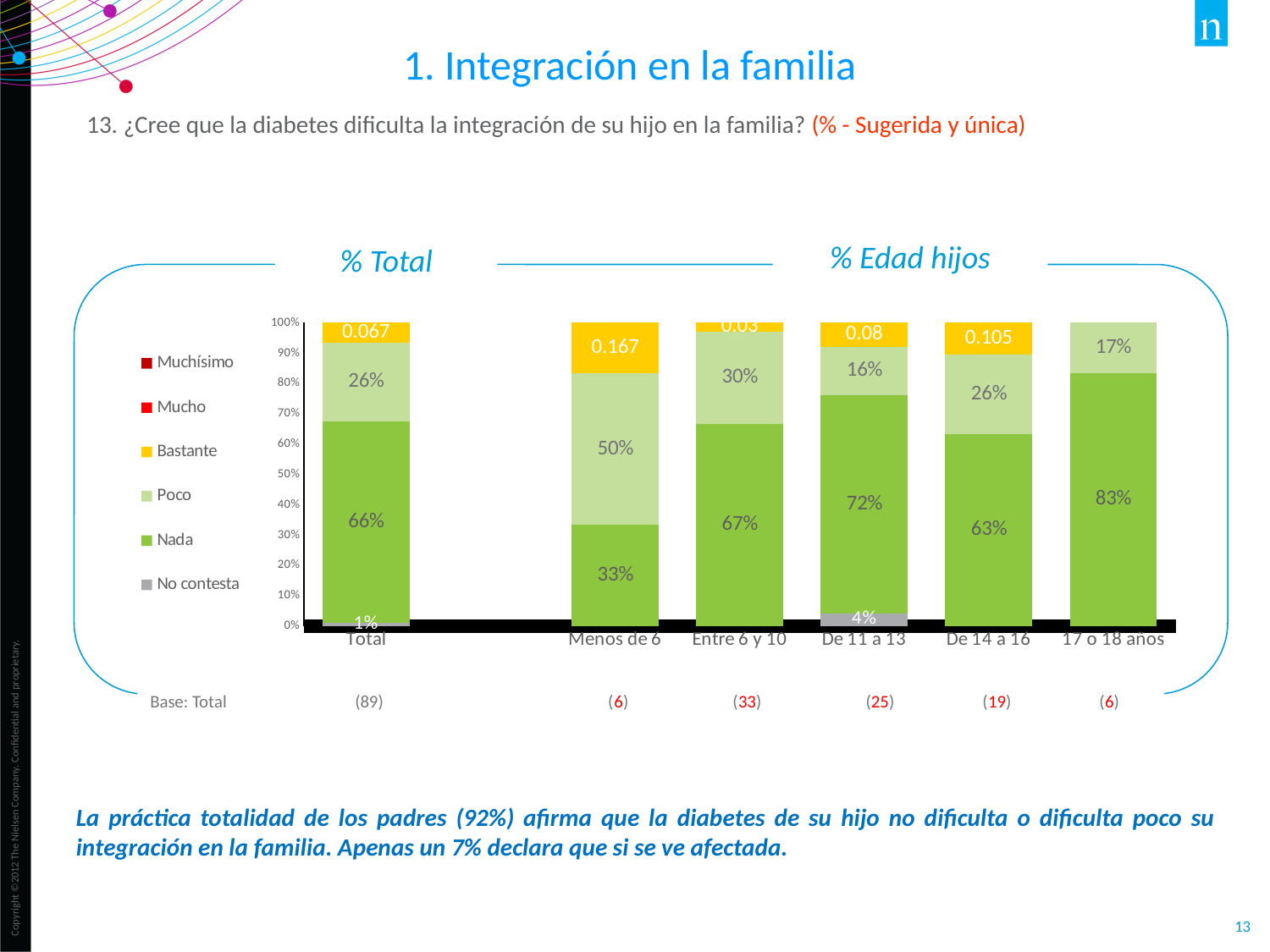
What is the difference between the "Nada" values for "17 o 18 años" and "De 14 a 16"? 20% What is the value of "Poco" for "Menos de 6"? 50% How many categories are shown along the x axis? 6 What is the value of "Nada" for the "Total" category? 66% Which category has the highest value for "Nada"? 17 o 18 años What is the value of "Nada" for "De 11 a 13"? 72% Which category has the lowest value for "Nada"? Menos de 6 How many series does the legend list? 6 Which is larger: the "Poco" value for "Entre 6 y 10" or for "De 11 a 13"? Entre 6 y 10 What is the value of "No contesta" for "De 11 a 13"? 4% What kind of chart is shown on the slide? stacked bar chart What is the value of "Bastante" for "De 14 a 16"? 0.105